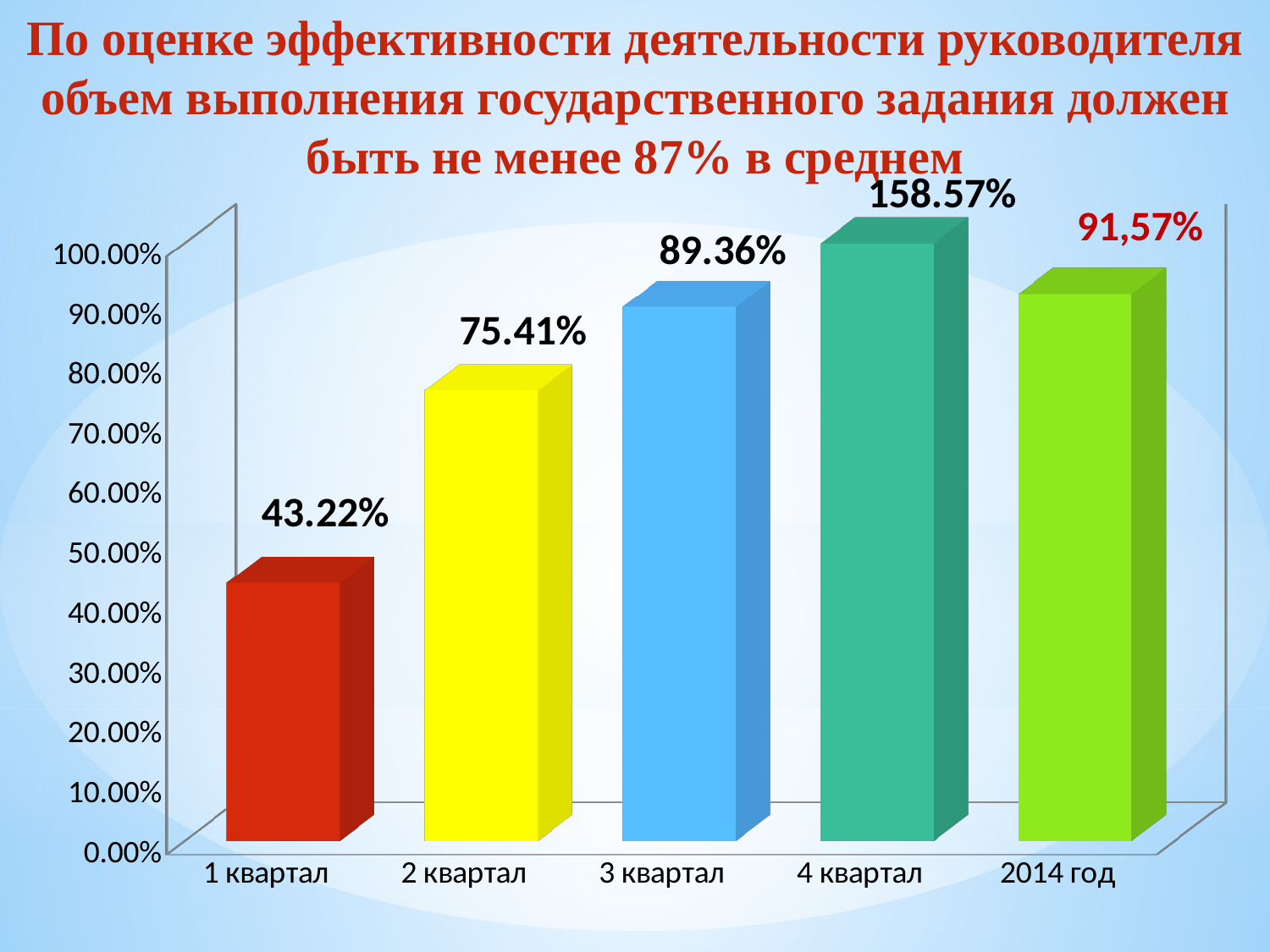
What is the value for 3 квартал? 89.36% How many categories are shown on the x axis? 5 What is the value for 1 квартал? 43.22% Which category has the lowest value? 1 квартал What is the value for 4 квартал? 158.57% What is the value labelled for 2014 год? 91,57% What is the value for 2 квартал? 75.41% What is the difference between the values for 2 квартал and 1 квартал? 32.19% Which is larger, the value for 3 квартал or the value for 2 квартал? 3 квартал Is the value for 1 квартал greater or less than 50.00%? less Which category has the highest value? 4 квартал What kind of chart is shown on the slide? bar chart